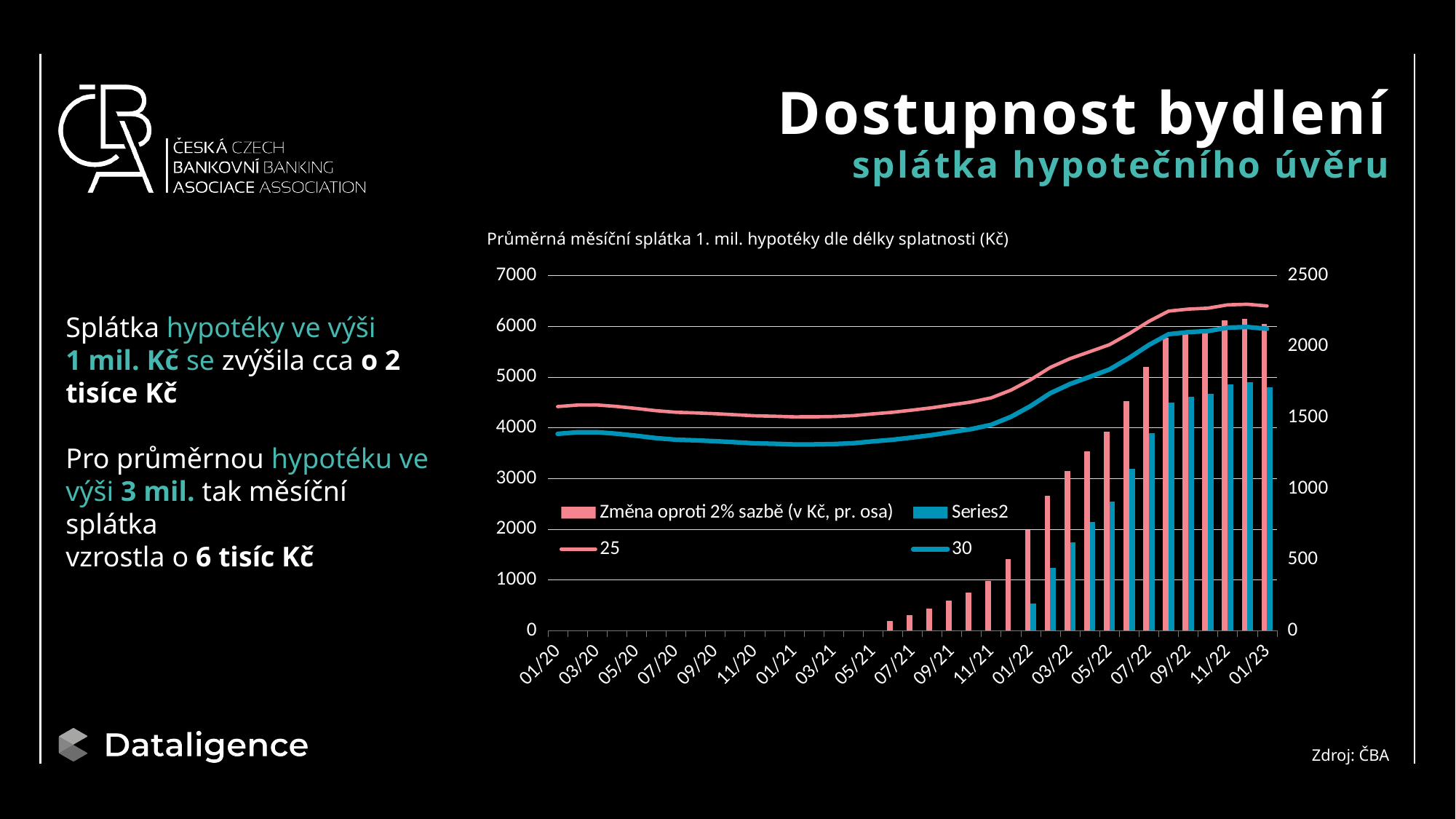
How many series does the chart legend list? 4 What type of chart is shown on the slide? Combined line and bar chart Is the value of the '30' line at 01/21 greater or less than 4000? less Is the value of the '25' line at 01/23 greater or less than 6000? greater At 11/22, which bar is taller, 'Změna oproti 2% sazbě (v Kč, pr. osa)' or 'Series2'? Změna oproti 2% sazbě (v Kč, pr. osa) Which line is higher at 01/23, '25' or '30'? 25 Is the value of the '30' line at 01/23 greater or less than 5000? greater Does the '30' line rise or fall between 01/20 and 03/21? fall Does the '25' line rise or fall between 01/22 and 01/23? rise What is the title of the chart? Průměrná měsíční splátka 1. mil. hypotéky dle délky splatnosti (Kč) How many date labels are shown on the x axis? 19